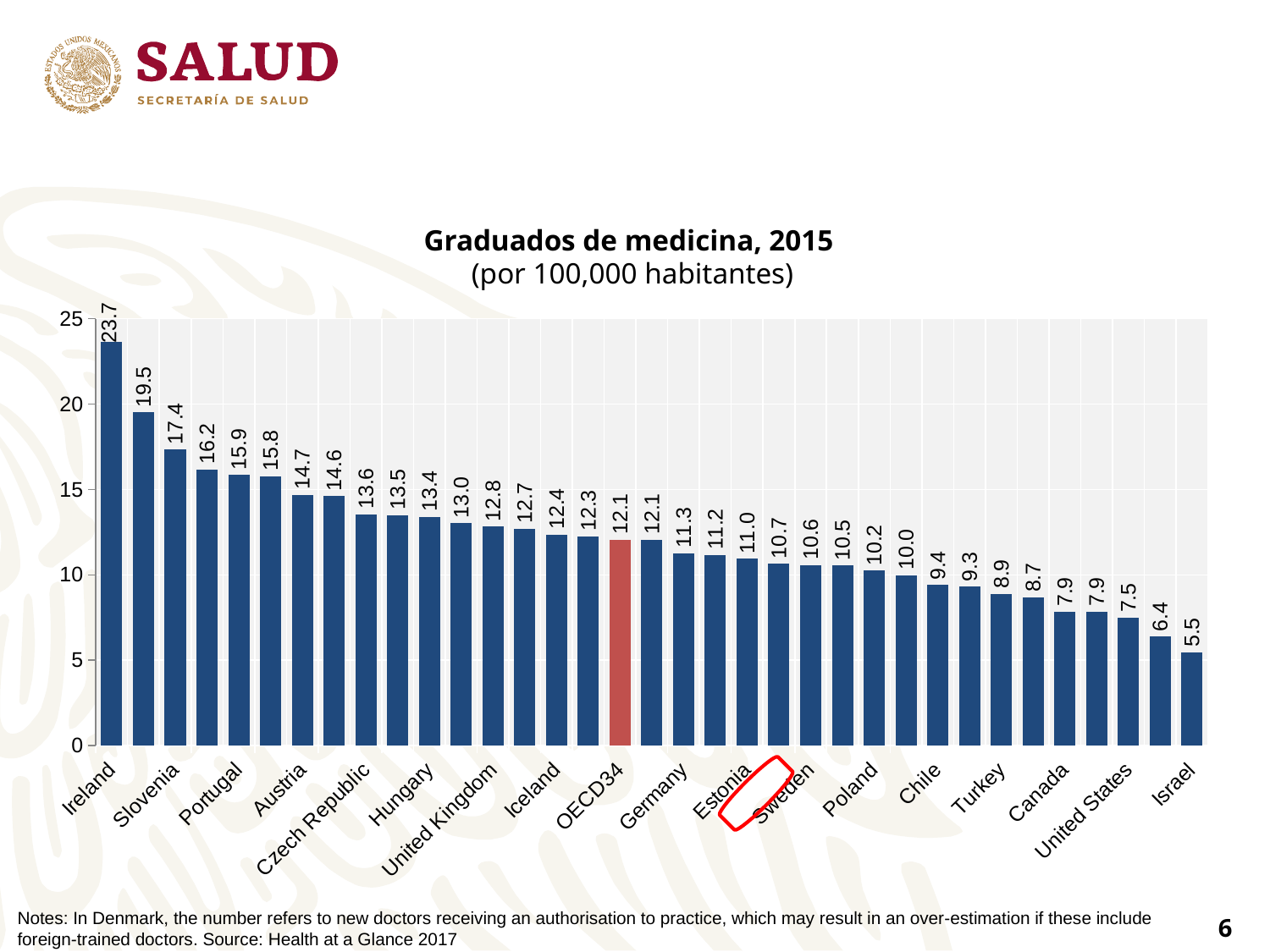
Which category has the lowest value? Israel Which category has the highest value? Ireland What is the title of the chart? Graduados de medicina, 2015 (por 100,000 habitantes) Is the value for Ireland greater or less than 20? greater What is the value for Ireland? 23.7 What is the value for OECD34? 12.1 What is the value for Israel? 5.5 Do the values rise or fall from left to right along the x axis? fall What is the difference between the values for Ireland and Israel? 18.2 Which category is shown with a red bar instead of a blue one? OECD34 What type of chart is shown on the slide? bar chart Which is larger, the value for Ireland or the value for OECD34? Ireland